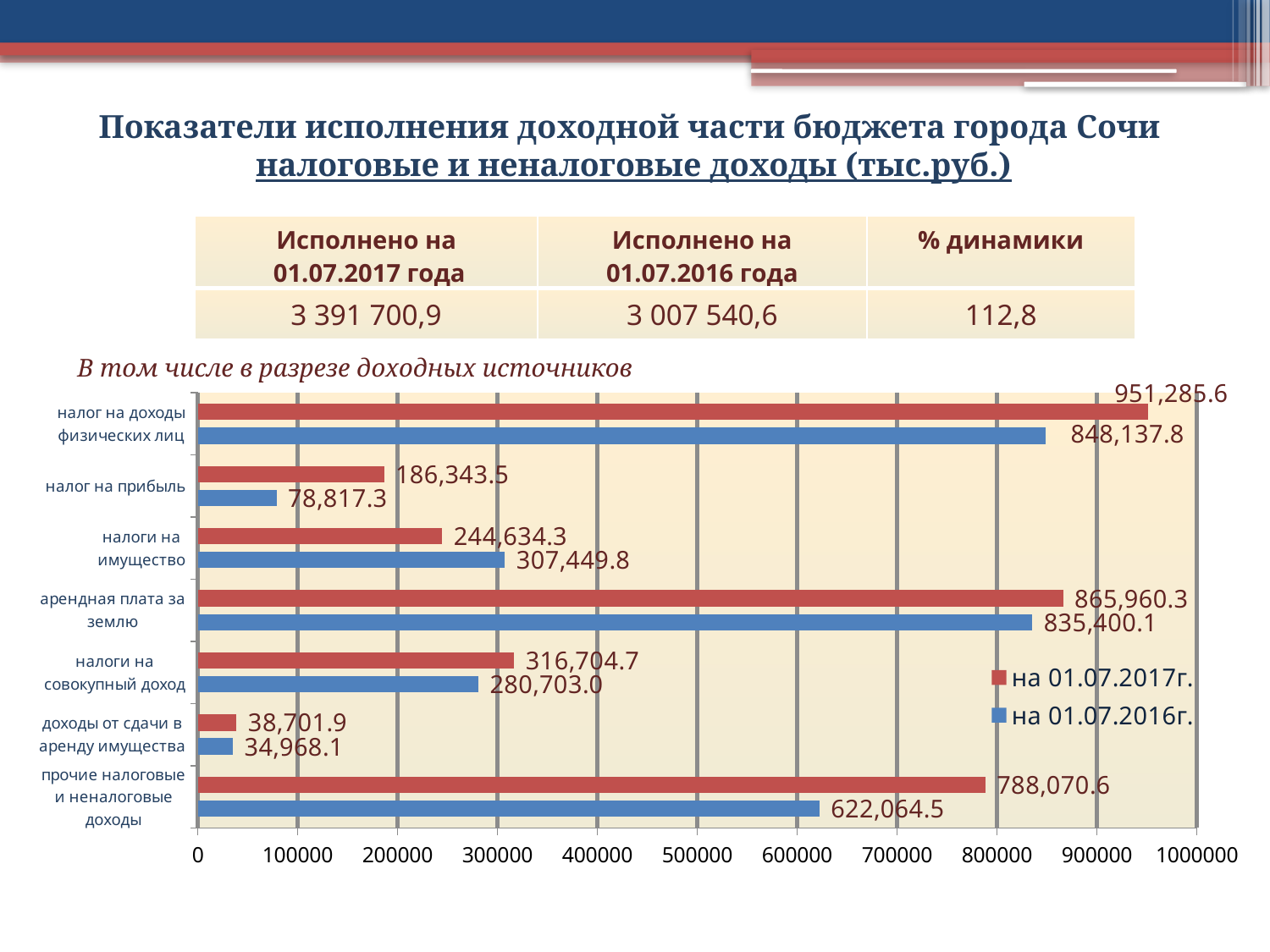
What is the value for 'доходы от сдачи в аренду имущества' for the series 'на 01.07.2017г.'? 38,701.9 Which category has the lowest value for the series 'на 01.07.2016г.'? доходы от сдачи в аренду имущества What is the difference between the 'на 01.07.2017г.' and 'на 01.07.2016г.' values for 'налог на прибыль'? 107,526.2 Which category has the highest value for the series 'на 01.07.2017г.'? налог на доходы физических лиц What is the value for 'налог на доходы физических лиц' for the series 'на 01.07.2017г.'? 951,285.6 For 'налоги на имущество', which series has the larger value: 'на 01.07.2017г.' or 'на 01.07.2016г.'? на 01.07.2016г. How many series does the chart legend list? 2 Which colour represents the series 'на 01.07.2016г.' in the chart? blue What kind of chart is shown on the slide? bar chart What is the value for 'налоги на имущество' for the series 'на 01.07.2016г.'? 307,449.8 How many income source categories are plotted on the chart? 7 What is the value for 'прочие налоговые и неналоговые доходы' for the series 'на 01.07.2016г.'? 622,064.5